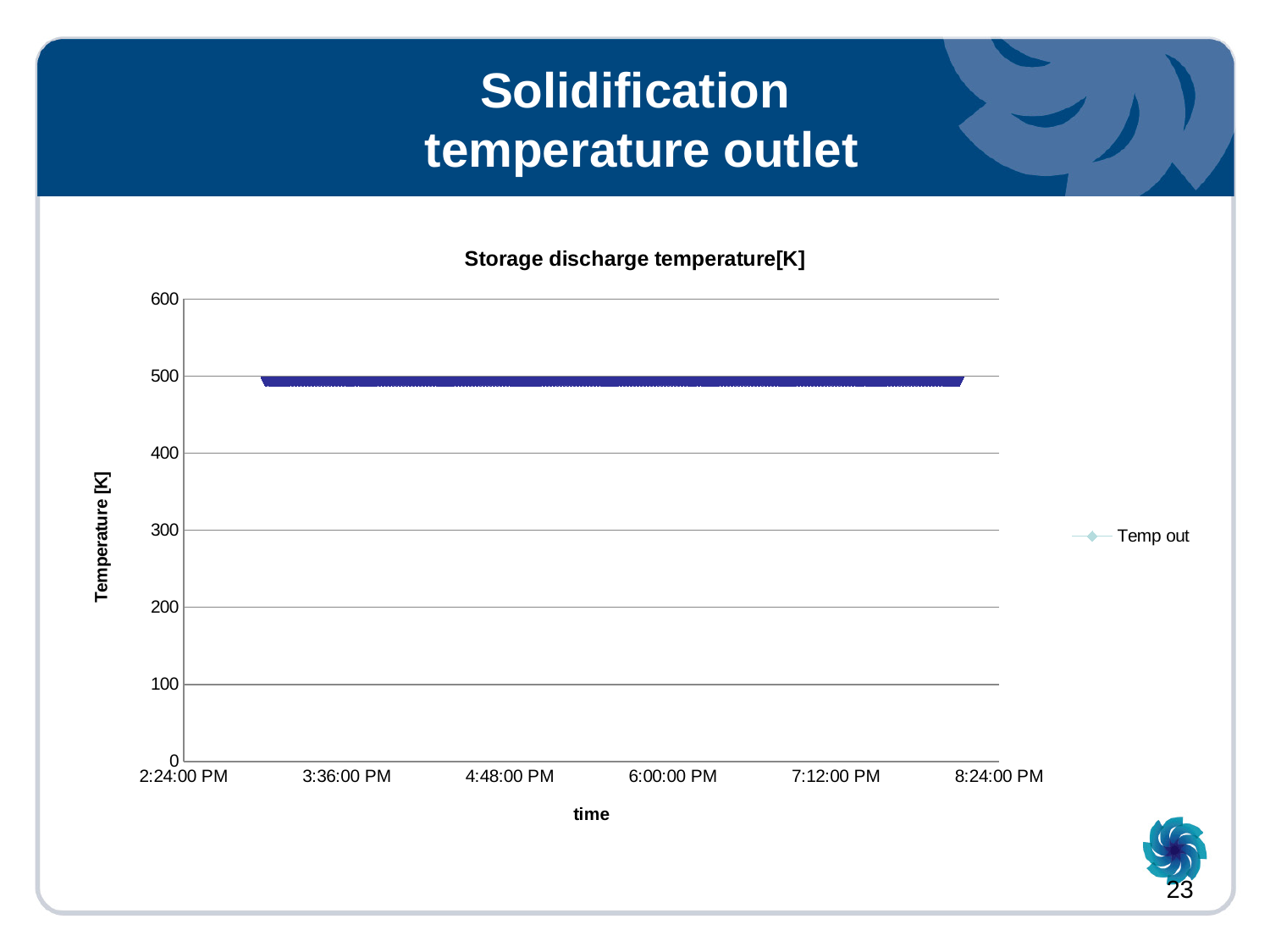
Is the value of Temp out at 6:00:00 PM greater or less than 600? less Is the value of Temp out at 4:48:00 PM greater or less than 400? greater What type of chart is shown on the slide? line chart What is the name of the series shown in the legend? Temp out Is the value of Temp out at 7:12:00 PM greater or less than 300? greater Does the Temp out series rise, fall, or stay roughly constant over time? stays roughly constant What is the highest value shown on the y axis? 600 What is the title of the chart? Storage discharge temperature[K] How many series does the legend list? 1